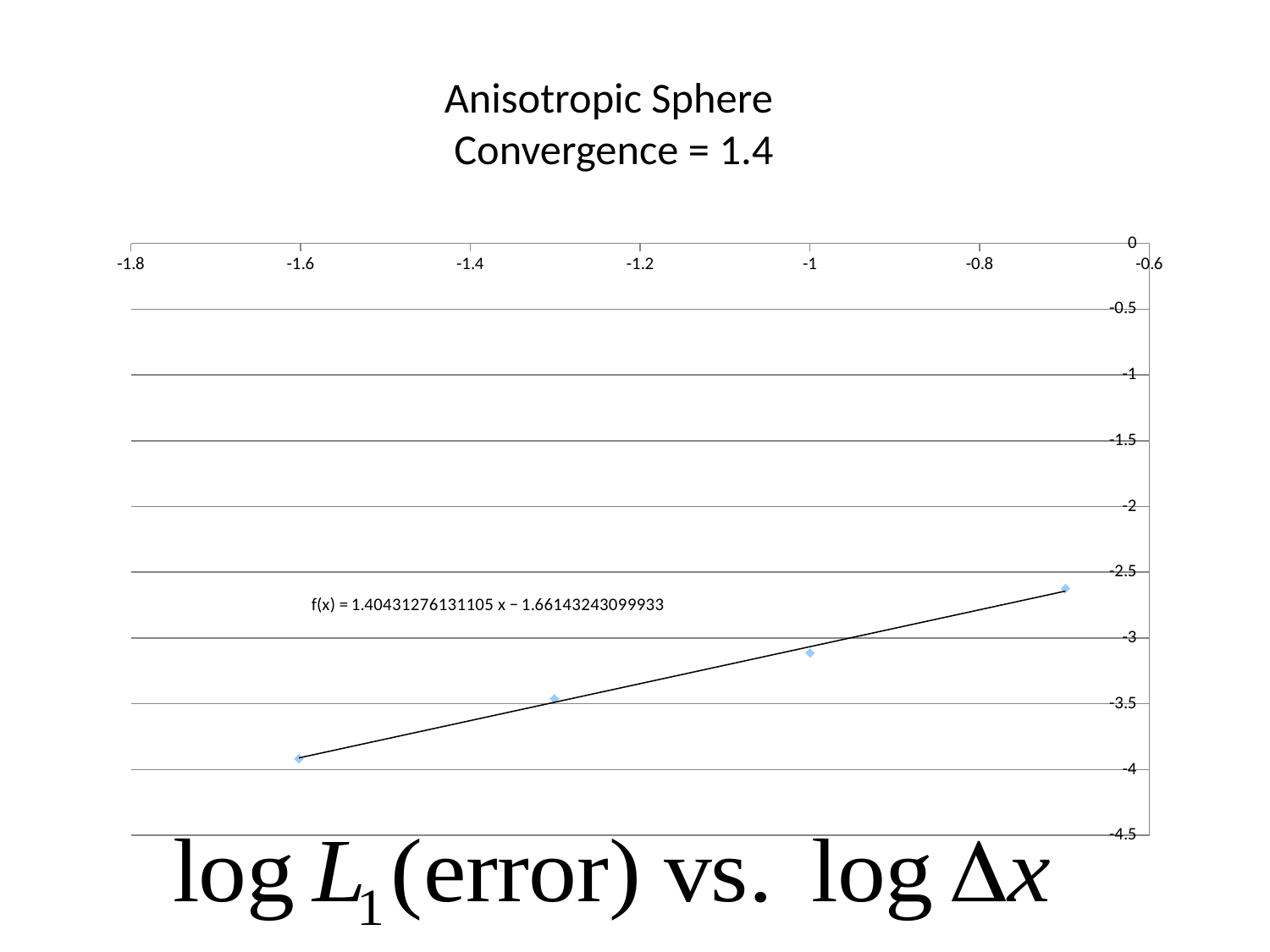
Which data point has the lowest y value, the leftmost or the rightmost? the leftmost What is the lowest value shown on the y axis? -4.5 Is the y value of the data point near x = -1 greater or less than -3.5? greater How many data points are plotted on the chart? 4 What is the intercept of the fitted trendline equation shown on the chart? -1.66143243099933 What convergence value is stated in the chart title? 1.4 Do the plotted values rise or fall as x increases from -1.6 to -0.7? rise What kind of chart is shown on the slide? scatter chart What is the slope of the fitted trendline equation shown on the chart? 1.40431276131105 Is the y value of the leftmost data point (near x = -1.6) greater or less than -3.5? less Which data point has the highest y value, the leftmost or the rightmost? the rightmost Is the y value of the rightmost data point (near x = -0.7) greater or less than -3? greater